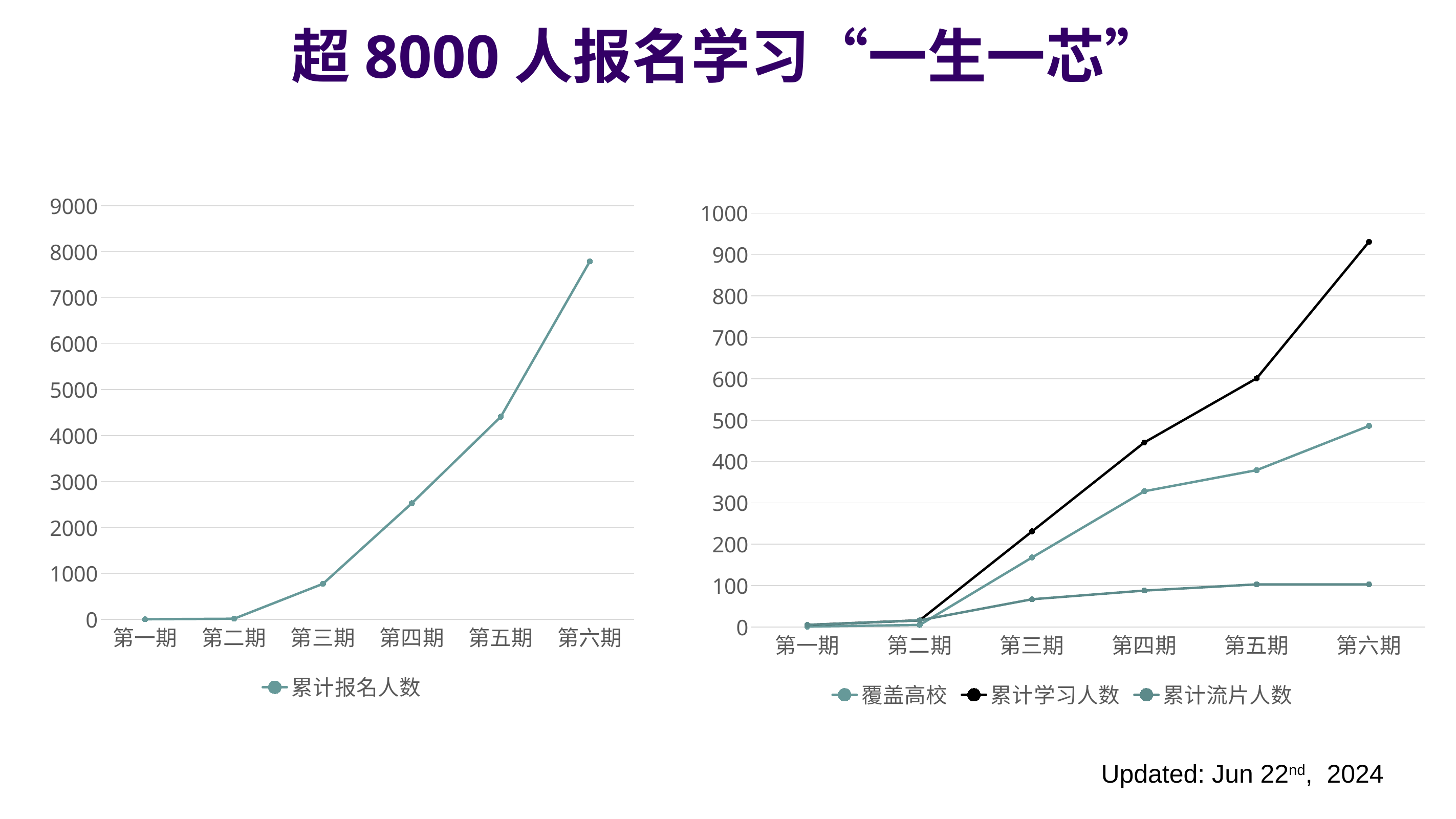
In the left chart (累计报名人数), which period has the highest value? 第六期 In the right chart, which series has the highest value at 第六期? 累计学习人数 In the left chart (累计报名人数), is the value for 第三期 greater or less than 1000? less How many series does the legend of the right chart list? 3 What kind of chart is the left chart (累计报名人数)? line chart In the left chart (累计报名人数), is the value for 第六期 greater or less than 7000? greater In the left chart (累计报名人数), do the values rise or fall from 第一期 to 第六期? rise In the right chart, is the value of 累计学习人数 for 第六期 greater or less than 900? greater In the right chart, which is larger at 第四期: 累计学习人数 or 累计流片人数? 累计学习人数 How many periods are shown on the x axis of the left chart (累计报名人数)? 6